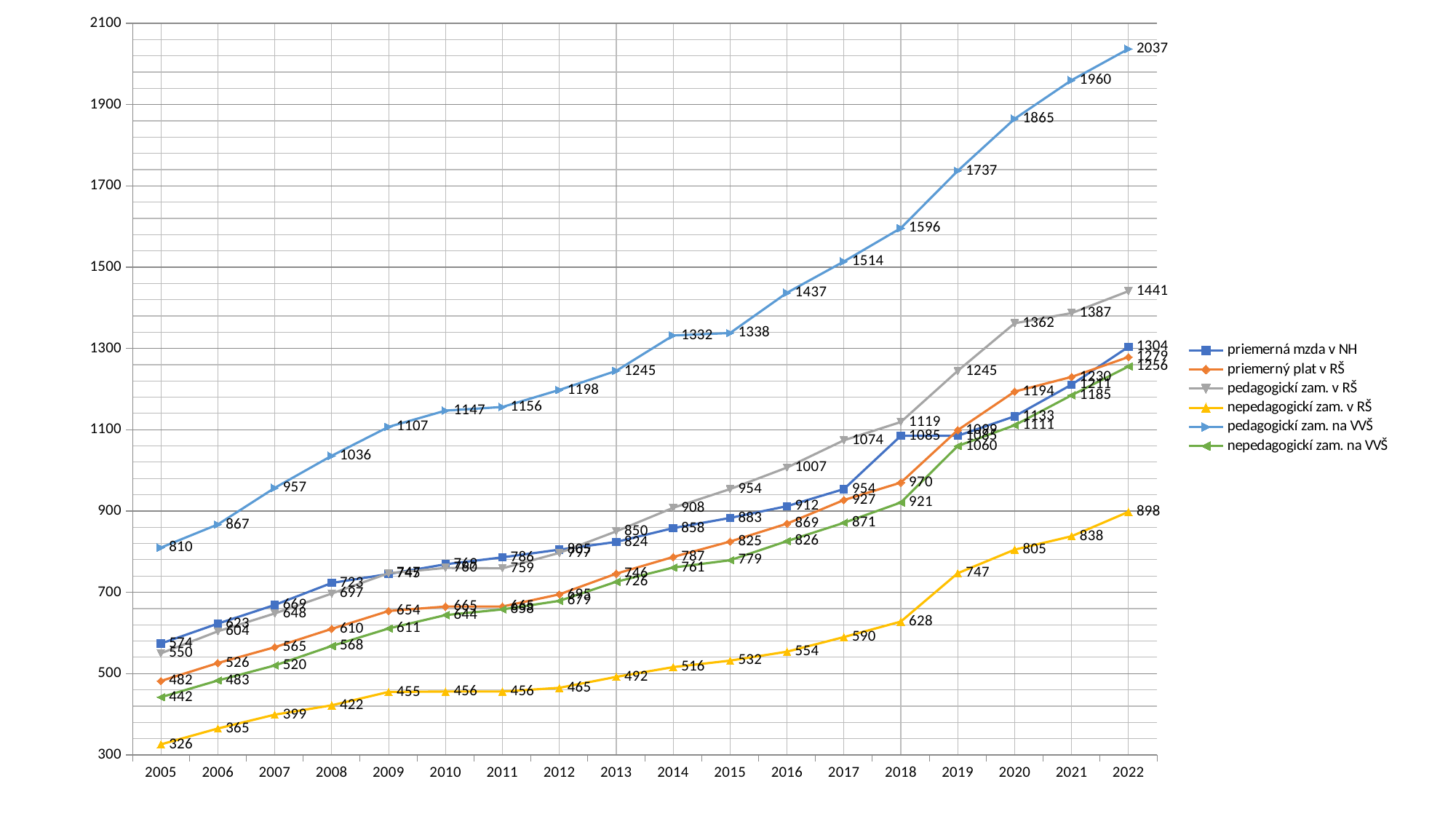
Does the value for nepedagogickí zam. v RŠ rise or fall from 2005 to 2022? rise What type of chart is shown on the slide? line chart How many years are plotted along the x axis? 18 Which series has the highest value in 2022? pedagogickí zam. na VVŠ What is the value for priemerný plat v RŠ in 2020? 1194 What is the value for pedagogickí zam. na VVŠ in 2022? 2037 What is the difference between the pedagogickí zam. na VVŠ values in 2022 and 2005? 1227 How many series does the legend list? 6 What is the value for nepedagogickí zam. v RŠ in 2005? 326 What is the value for pedagogickí zam. v RŠ in 2016? 1007 Which series has the lowest value in 2013? nepedagogickí zam. v RŠ Which is larger in 2018: priemerná mzda v NH or priemerný plat v RŠ? priemerná mzda v NH